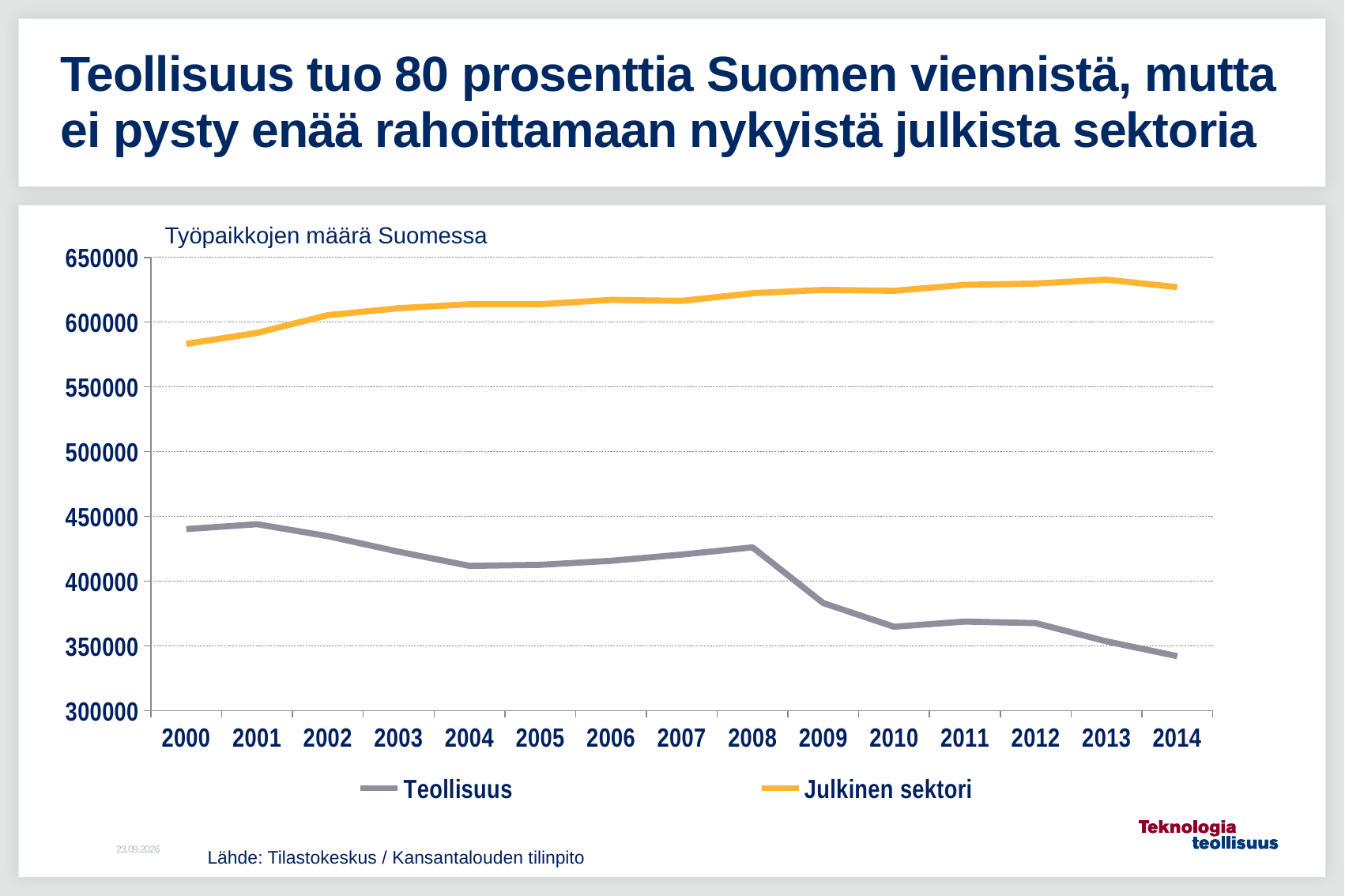
In which year is the Teollisuus series at its lowest? 2014 What is the title of the chart? Työpaikkojen määrä Suomessa How many series does the legend list? 2 Does the Julkinen sektori series rise or fall overall from 2000 to 2014? rise Which series is drawn in yellow? Julkinen sektori Which series has the higher value in 2014, Teollisuus or Julkinen sektori? Julkinen sektori Is the value for Julkinen sektori in 2000 greater or less than 600000? less Does the Teollisuus series rise or fall overall from 2000 to 2014? fall What kind of chart is shown on the slide? line chart How many years are plotted along the x axis? 15 In which year is the Julkinen sektori series at its lowest? 2000 Is the value for Teollisuus in 2014 greater or less than 350000? less